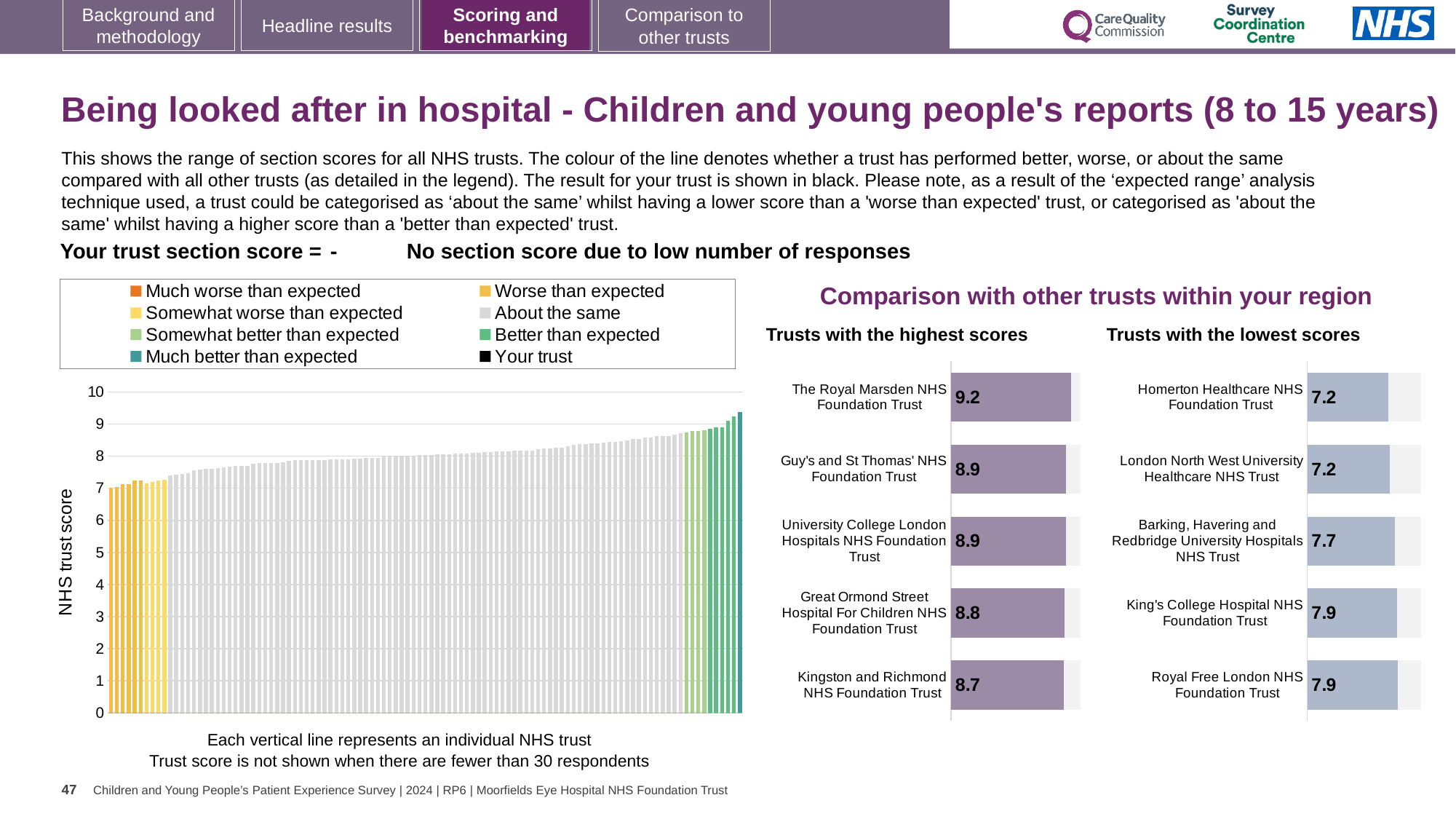
How many entries does the legend of the NHS trust score chart list? 8 In the 'Trusts with the lowest scores' chart, what is the difference between the scores of Royal Free London NHS Foundation Trust and Homerton Healthcare NHS Foundation Trust? 0.7 In the 'Trusts with the lowest scores' chart, what is the score for Barking, Havering and Redbridge University Hospitals NHS Trust? 7.7 In the NHS trust score chart on the left, is the value of the tallest bar greater or less than 9? greater In the NHS trust score chart on the left, do the values rise or fall from left to right? Rise What kind of chart is the NHS trust score chart on the left? Bar chart How many trusts are shown in the 'Trusts with the lowest scores' chart? 5 In the 'Trusts with the lowest scores' chart, which has the higher score: Barking, Havering and Redbridge University Hospitals NHS Trust or Homerton Healthcare NHS Foundation Trust? Barking, Havering and Redbridge University Hospitals NHS Trust In the 'Trusts with the highest scores' chart, what is the score for The Royal Marsden NHS Foundation Trust? 9.2 In the 'Trusts with the highest scores' chart, which trust has the highest score? The Royal Marsden NHS Foundation Trust In the 'Trusts with the highest scores' chart, what is the difference between the scores of The Royal Marsden NHS Foundation Trust and Kingston and Richmond NHS Foundation Trust? 0.5 In the 'Trusts with the highest scores' chart, which trust has the lowest score? Kingston and Richmond NHS Foundation Trust